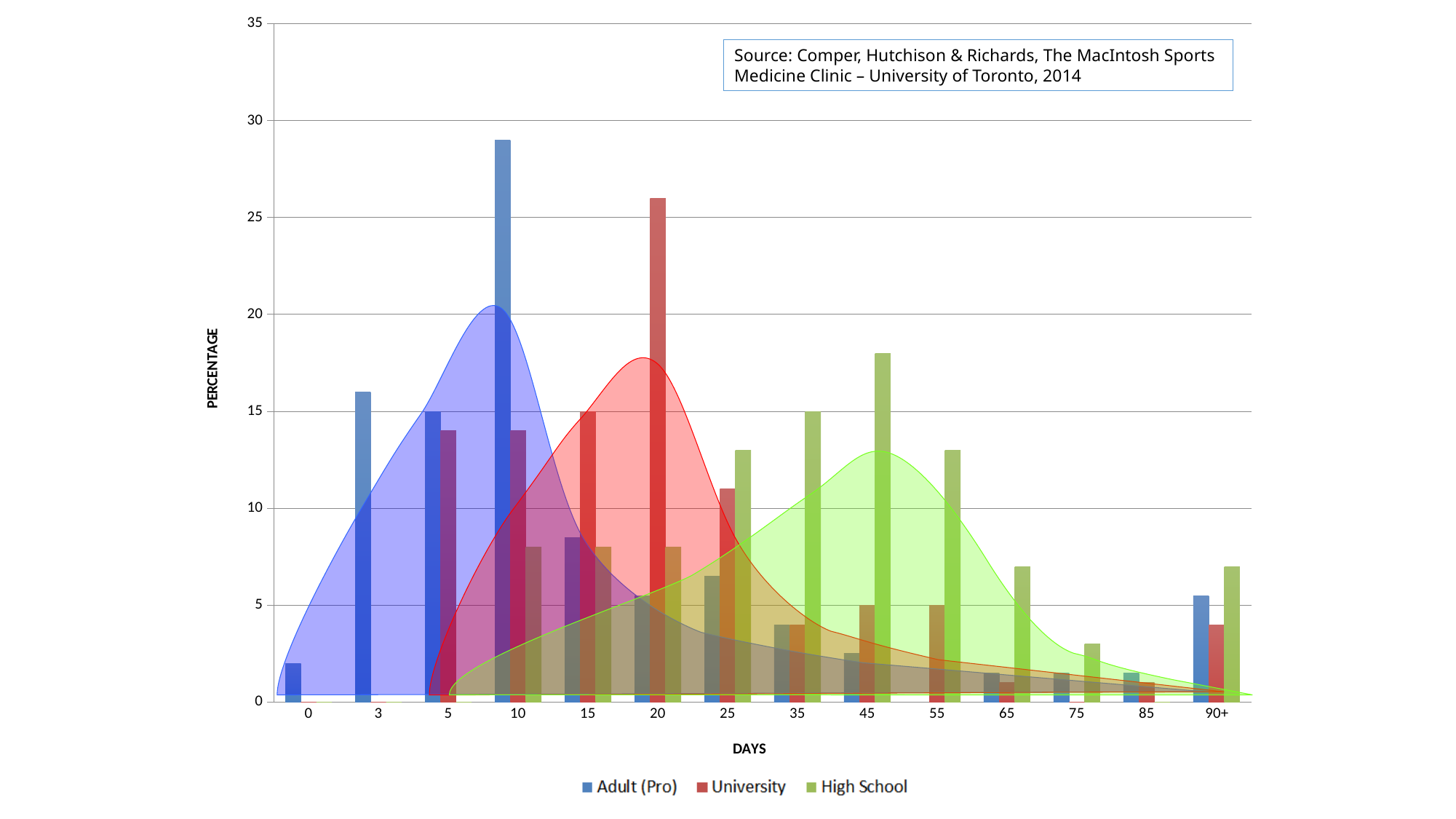
What is the value for University at 45 days? 5 How many series does the legend list? 3 What is the value for University at 15 days? 15 What is the value for Adult (Pro) at 5 days? 15 At which number of days is the High School series highest? 45 At which number of days is the Adult (Pro) series highest? 10 Which is larger: the Adult (Pro) value at 10 days or the University value at 20 days? Adult (Pro) at 10 days Is the value for Adult (Pro) at 10 days greater or less than 25? greater At which number of days is the University series highest? 20 How many categories are shown along the x axis? 14 What type of chart is shown on the slide? Bar chart What is the value for High School at 35 days? 15